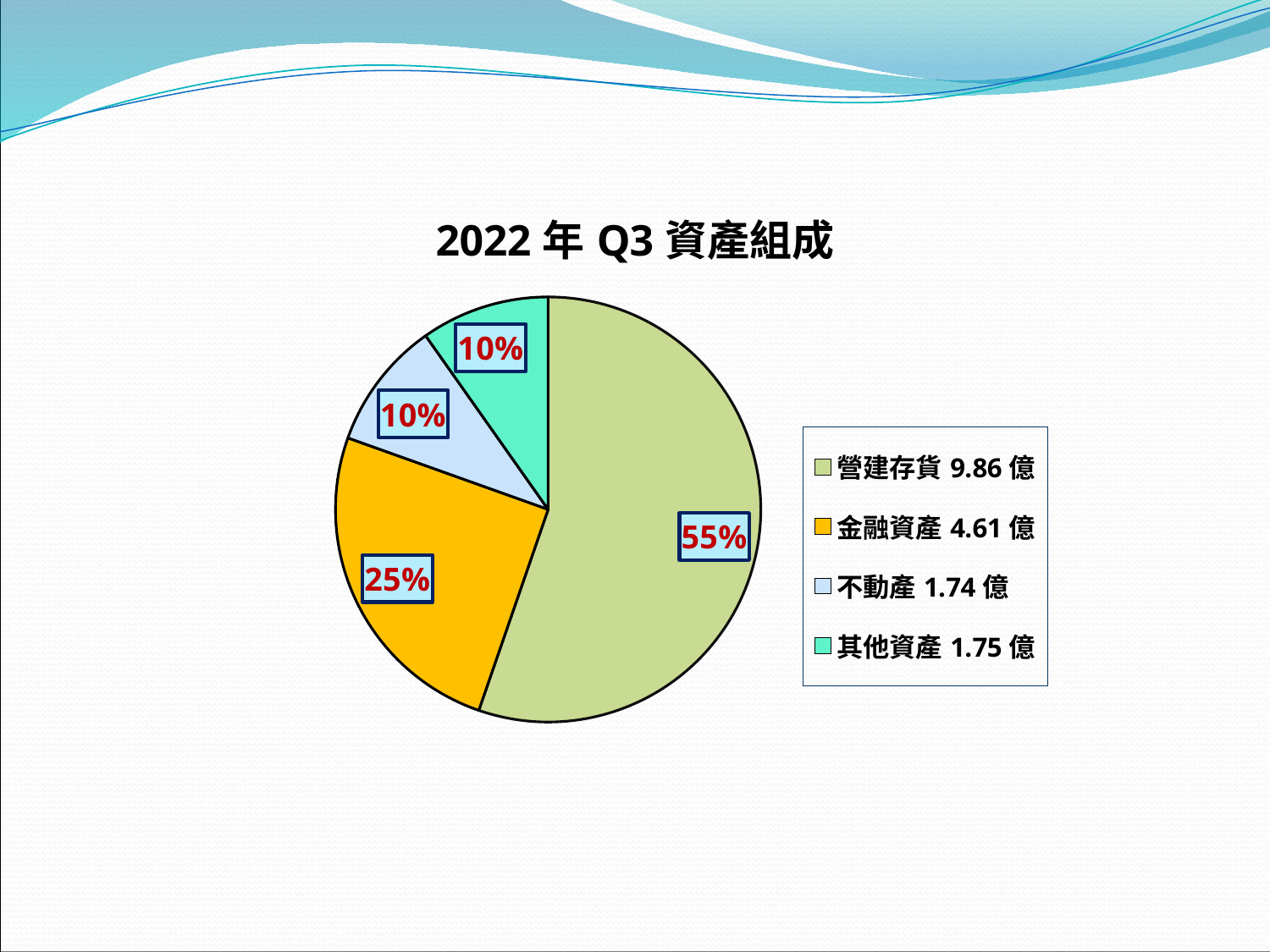
Which is larger, 金融資產 or 不動產? 金融資產 How many slices does the pie chart have? 4 What share of the pie does 營建存貨 represent? 55% What is the difference between the values for 營建存貨 and 金融資產? 5.25 億 What is the title of the chart? 2022 年 Q3 資產組成 What share of the pie does 金融資產 represent? 25% What value does the legend give for 營建存貨? 9.86 億 What value does the legend give for 其他資產? 1.75 億 What kind of chart is shown on the slide? pie chart Which category has the largest slice of the pie? 營建存貨 What value does the legend give for 金融資產? 4.61 億 What share of the pie does 不動產 represent? 10%